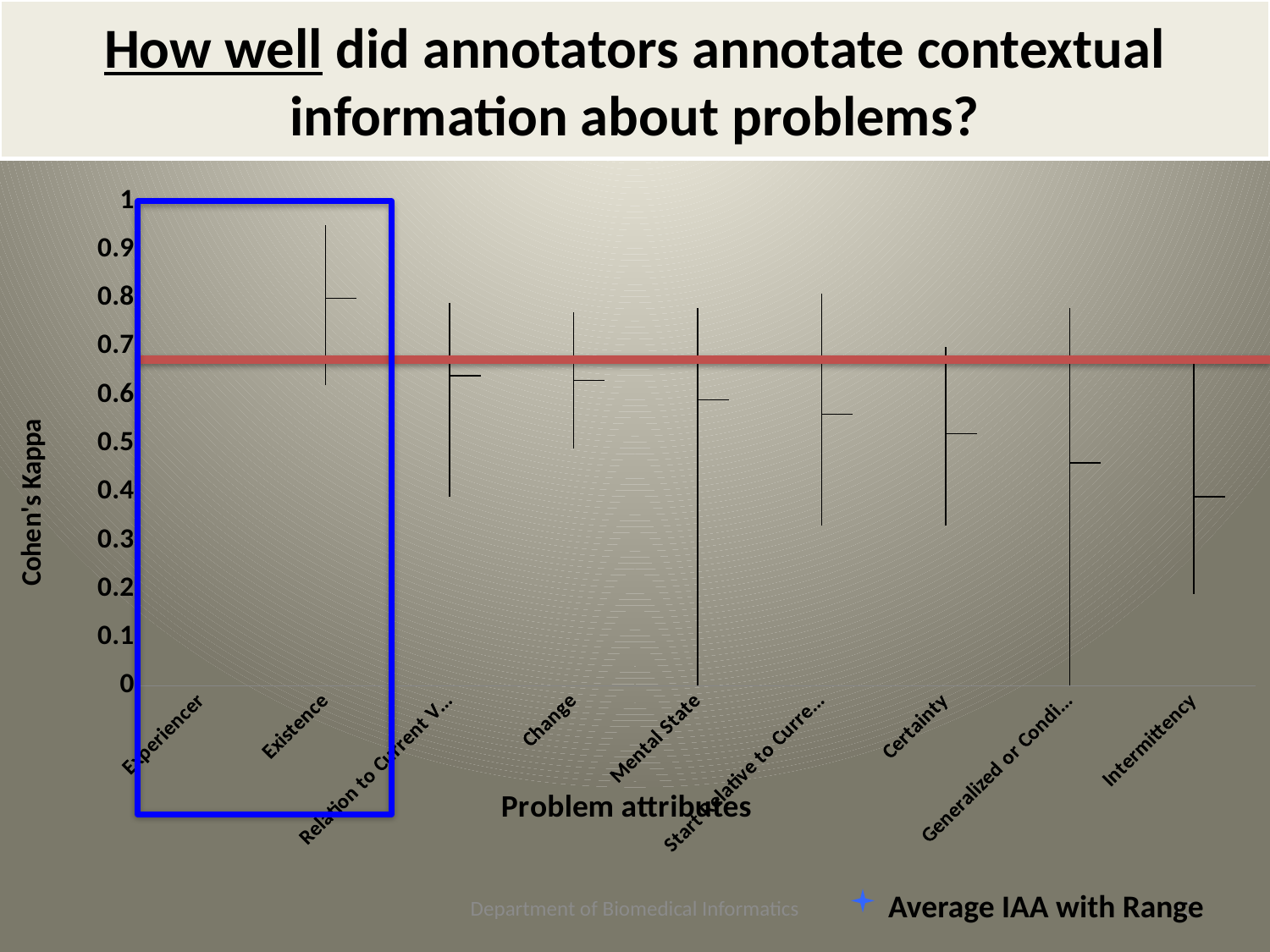
Which has a higher average IAA, Change or Certainty? Change How many problem attributes are listed on the x axis? 9 Is the average IAA for Mental State greater or less than 0.7? less What is the label of the y axis? Cohen's Kappa Is the average IAA for Generalized or Condi... greater or less than 0.5? less What does the legend entry say? Average IAA with Range Do the average IAA values generally rise or fall from Existence to Intermittency along the x axis? fall Which problem attribute has the lowest average IAA? Intermittency Is the average IAA for Existence greater or less than 0.7? greater Which has a higher average IAA, Existence or Intermittency? Existence